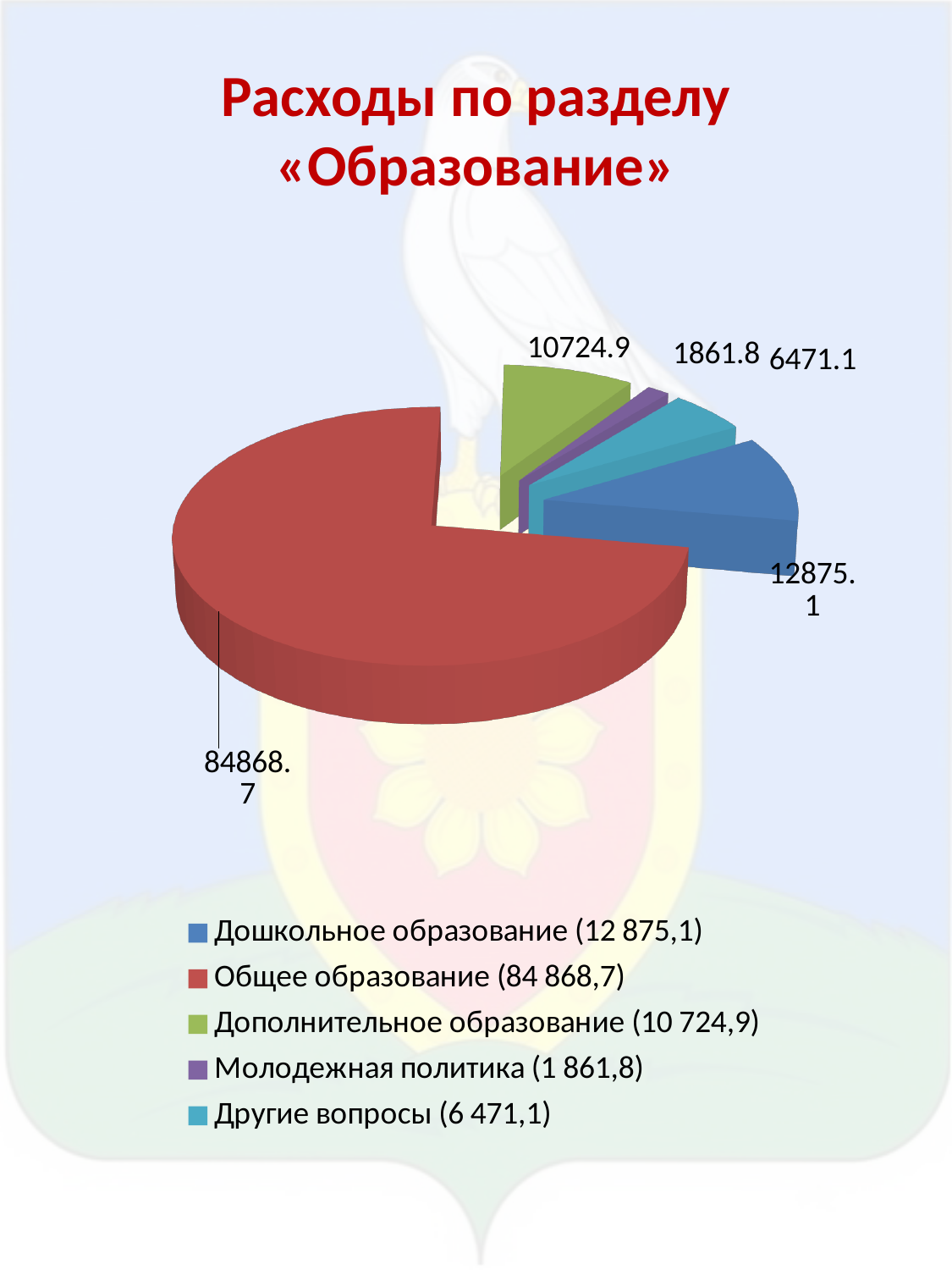
What is the value for Другие вопросы? 6471.1 What is the value for Общее образование? 84868.7 How many slices does the pie chart have? 5 Which category has the largest slice of the pie? Общее образование Which is larger, Дошкольное образование or Дополнительное образование? Дошкольное образование What is the difference between the values for Дошкольное образование and Дополнительное образование? 2150.2 What type of chart is shown on the slide? Pie chart What is the value for Дошкольное образование? 12875.1 Which category has the smallest slice of the pie? Молодежная политика What is the title of the chart? Расходы по разделу «Образование» Which colour represents Дополнительное образование in the legend? Green What is the value for Молодежная политика? 1861.8